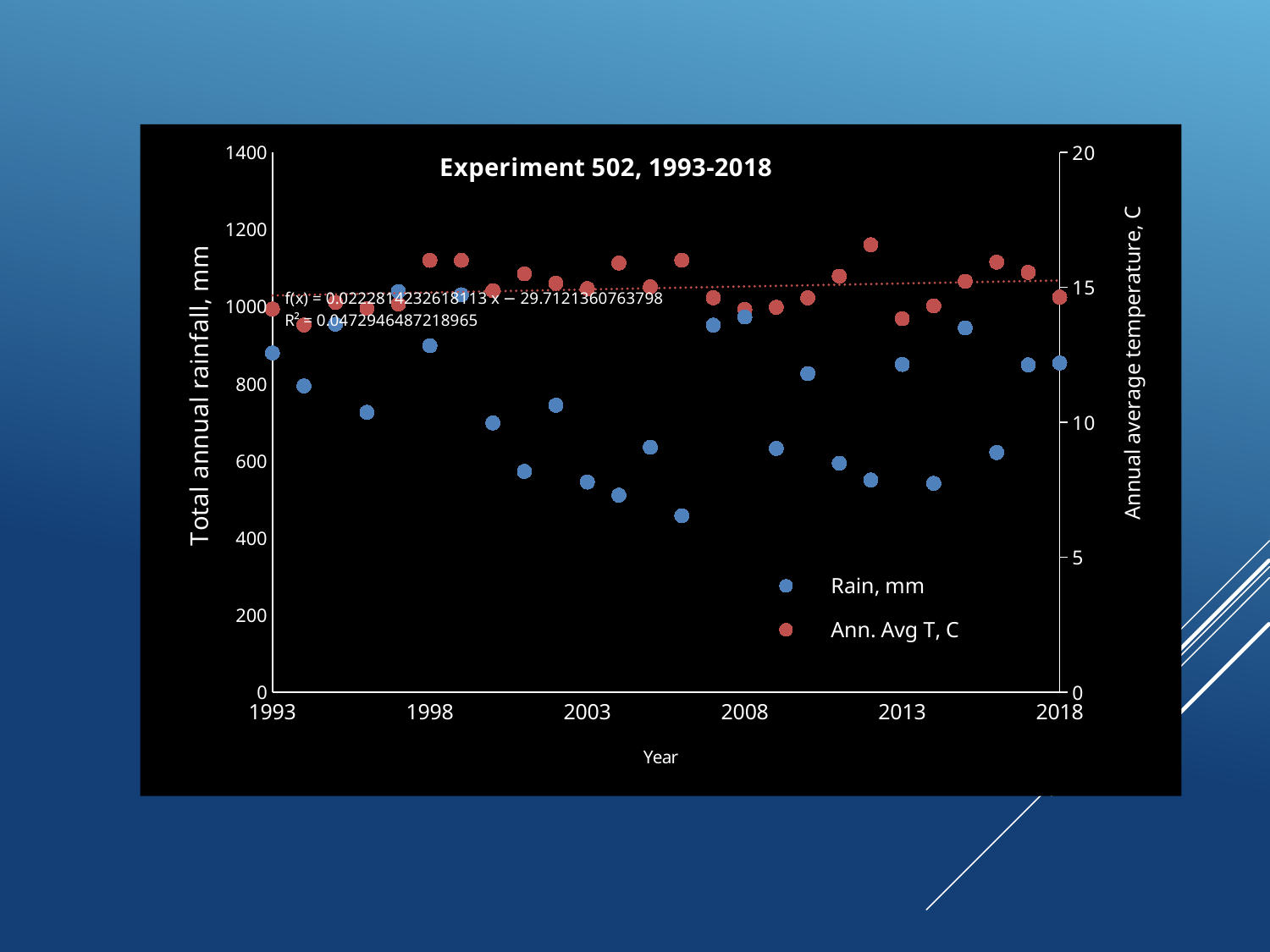
Is the Ann. Avg T, C value for 2012 greater or less than 15? greater In which year is the Rain, mm value lowest? 2006 How many series does the legend list? 2 Is the Rain, mm value for 1993 greater or less than 800? greater In which year is the Ann. Avg T, C value highest? 2012 Is the Rain, mm value for 2006 greater or less than 600? less Which year has the larger Rain, mm value, 1993 or 2006? 1993 Does the dotted trendline for Ann. Avg T, C rise or fall from 1993 to 2018? rises What kind of chart is shown on the slide? Scatter chart What is the title of the chart? Experiment 502, 1993-2018 What are the two series named in the legend? Rain, mm and Ann. Avg T, C